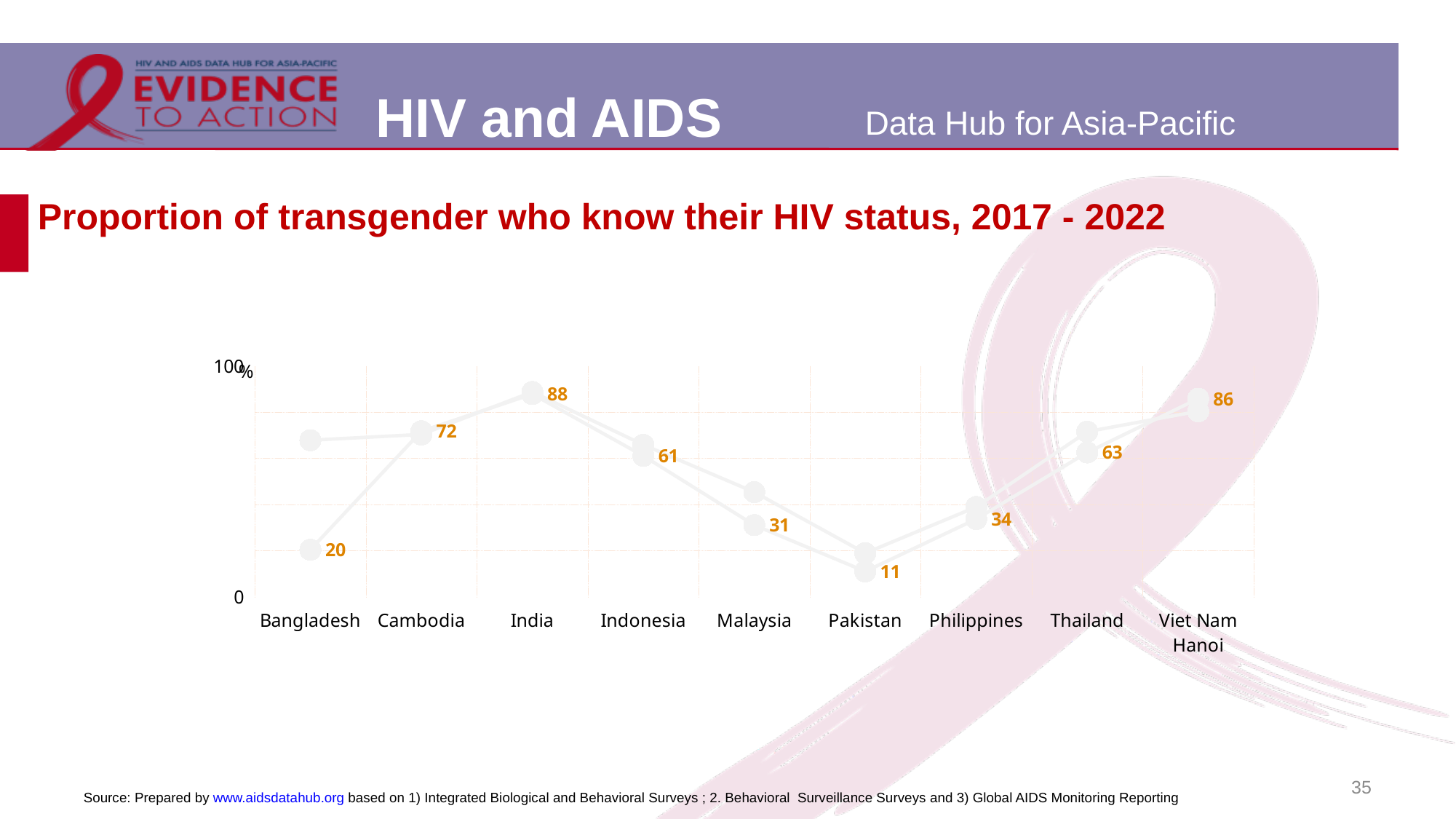
What kind of chart is shown on the slide? line chart What is the title of the chart? Proportion of transgender who know their HIV status, 2017 - 2022 What is the labelled value for Viet Nam Hanoi? 86 What is the labelled value for India? 88 What is the difference between the labelled values for India and Pakistan? 77 Which has the larger labelled value, Cambodia or Thailand? Cambodia Which country has the lowest labelled value? Pakistan Which country has the highest labelled value? India What is the labelled value for Pakistan? 11 How many countries are shown on the x axis? 9 Is the labelled value for Malaysia greater or less than 50? less What is the labelled value for Bangladesh? 20